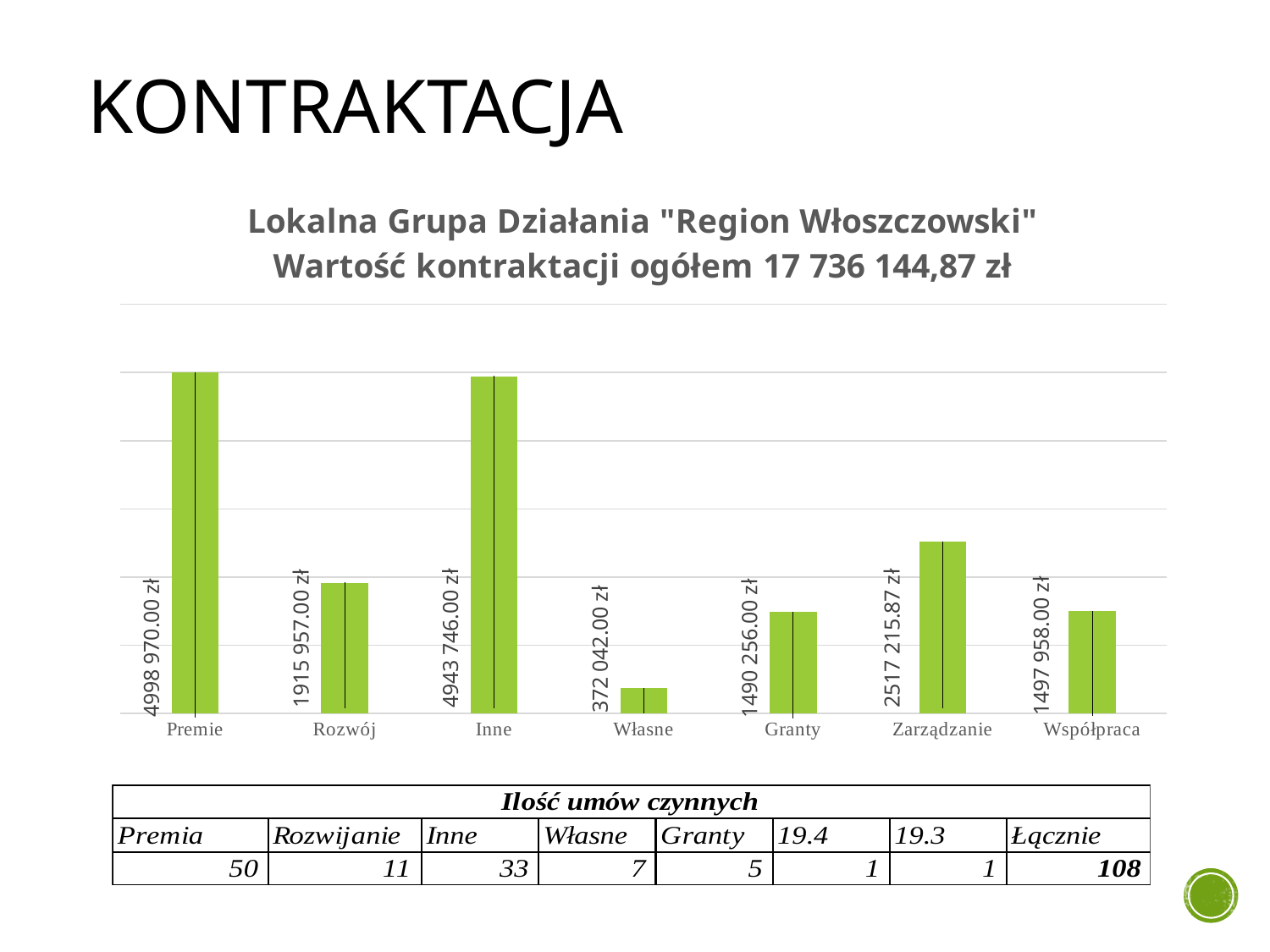
What is the value for Współpraca in the chart? 1497 958.00 zł What is the value for Premie in the chart? 4998 970.00 zł What kind of chart is shown on the slide? bar chart What is the difference between the values for Rozwój and Granty? 425 701.00 zł What is the difference between the values for Premie and Inne? 55 224.00 zł What total contract value is stated in the chart title? 17 736 144,87 zł Which category has the lowest value in the chart? Własne How many categories are shown in the chart? 7 What is the value for Zarządzanie in the chart? 2517 215.87 zł Which category has the highest value in the chart? Premie What is the value for Własne in the chart? 372 042.00 zł Which is larger, the value for Zarządzanie or the value for Rozwój? Zarządzanie